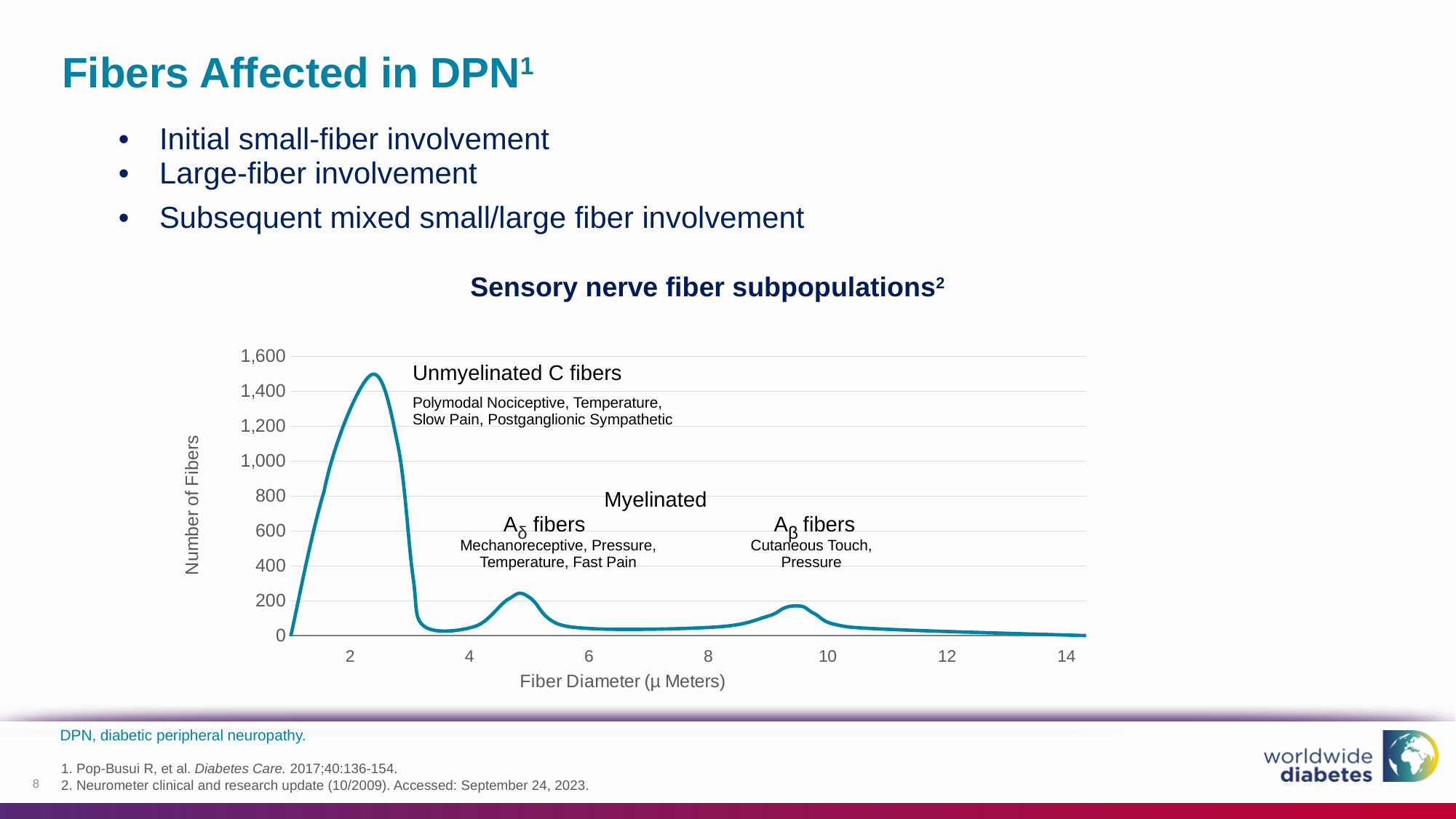
How many fiber subpopulations are labeled on the chart? 3 Is the peak value for Unmyelinated C fibers greater or less than 1,400? greater What is the label of the x axis of the chart? Fiber Diameter (µ Meters) Is the peak value for Aδ fibers greater or less than 400? less What is the title of the chart on the slide? Sensory nerve fiber subpopulations Which peak is higher, the Aδ fibers peak or the Aβ fibers peak? Aδ fibers Which of the three labeled fiber types has the lowest peak in the chart? Aβ fibers What kind of chart is shown under the title "Sensory nerve fiber subpopulations"? Line chart What is the highest value shown on the y axis of the chart? 1,600 Is the peak value for Aβ fibers greater or less than 200? less Which labeled fiber type has the highest peak in the chart? Unmyelinated C fibers Does the number of fibers rise or fall as fiber diameter increases from 10 to 14 µ meters? Fall